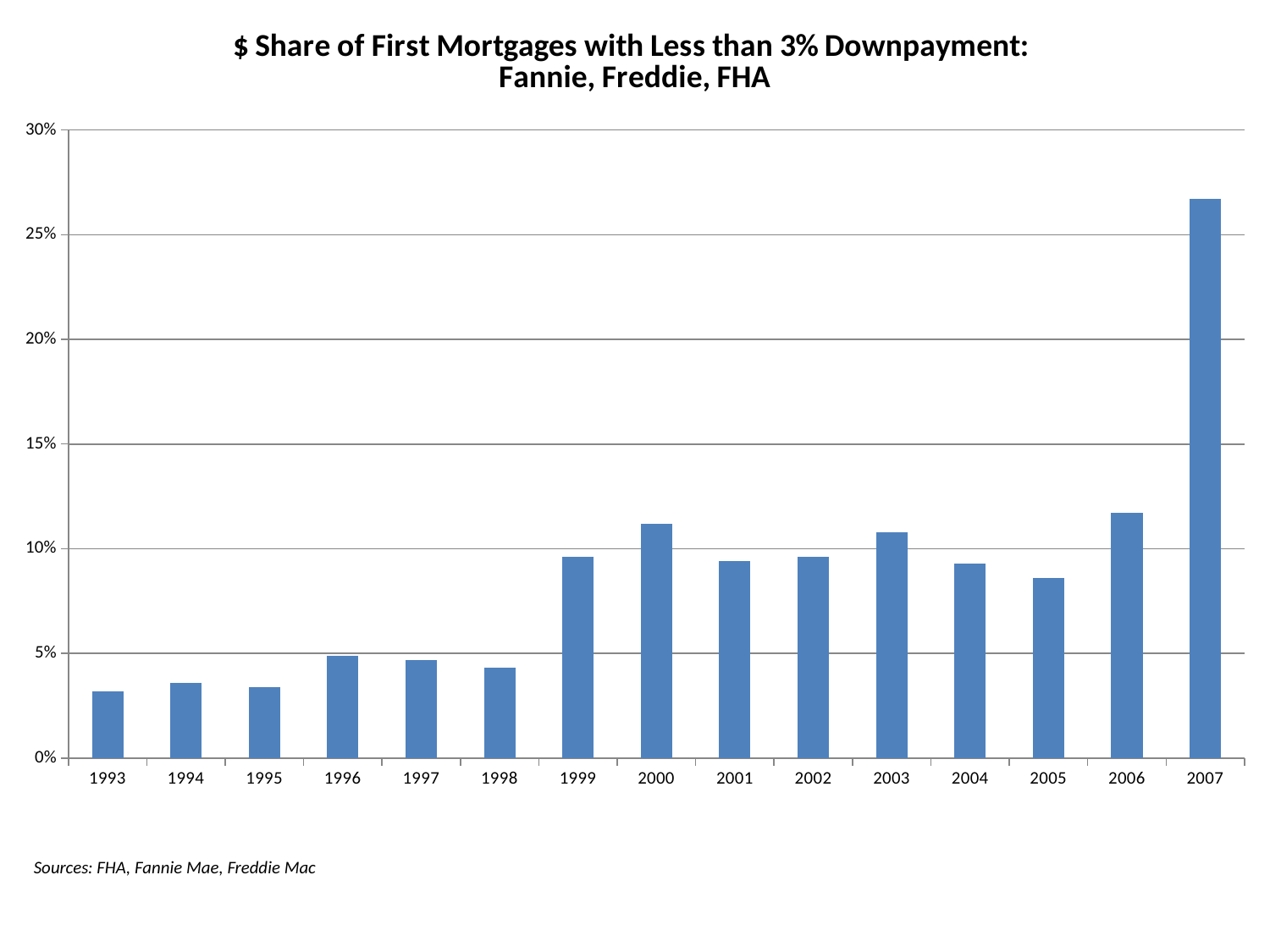
Is the value for 2007 greater or less than 25%? greater Is the value for 2005 greater or less than 10%? less Which year has the larger value, 1999 or 2000? 2000 What sources are cited below the chart? FHA, Fannie Mae, Freddie Mac Which year has the highest share of first mortgages with less than 3% downpayment? 2007 How many years are shown on the x axis of the chart? 15 Is the value for 2006 greater or less than 10%? greater What kind of chart is shown on the slide? Bar chart Overall, do the values rise or fall from 1993 to 2007? rise Which year has the larger value, 1998 or 2003? 2003